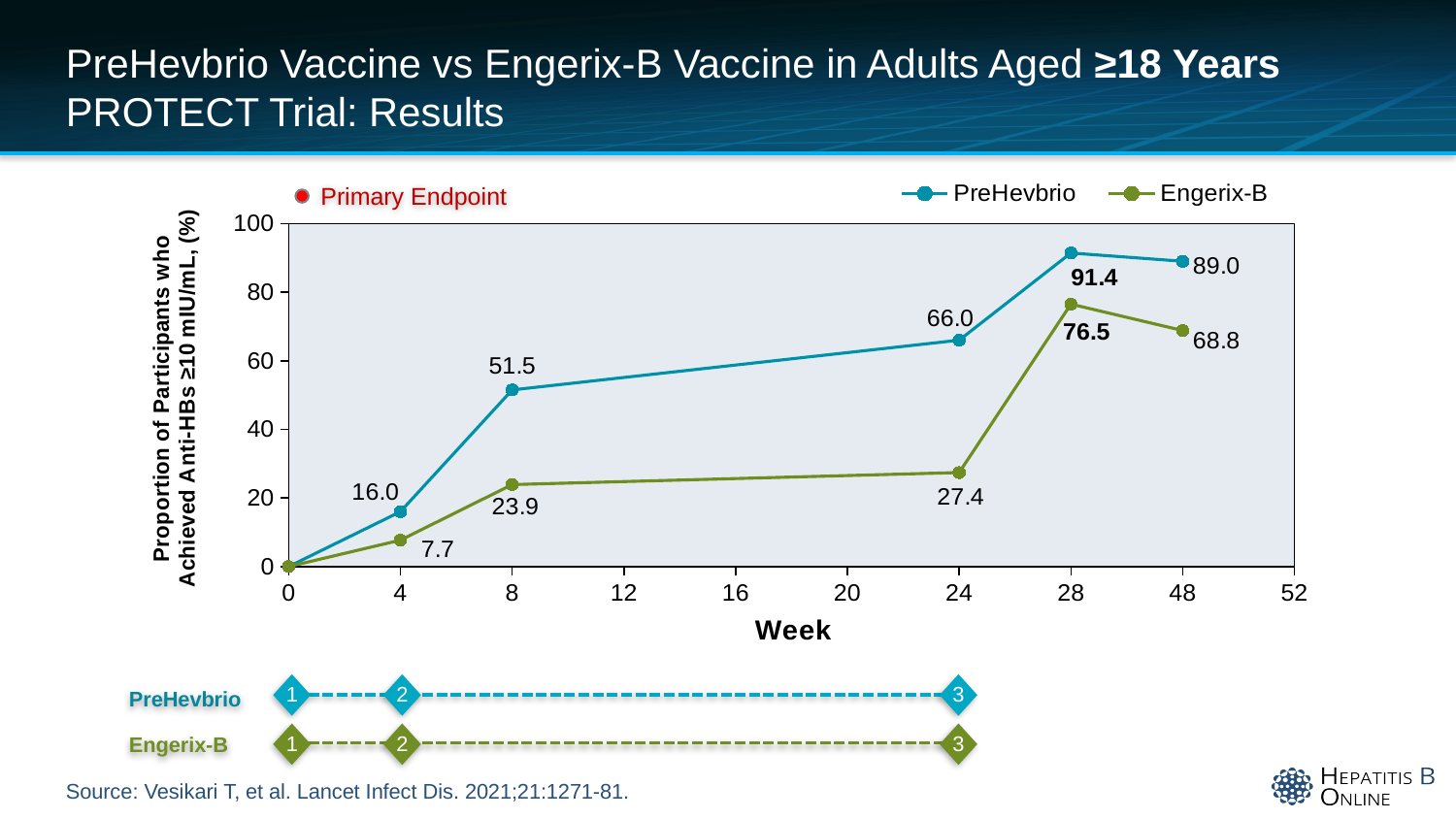
What is the difference between PreHevbrio and Engerix-B at week 24? 38.6 Is the value for Engerix-B at week 24 greater or less than 40? less Which series has the larger value at week 8, PreHevbrio or Engerix-B? PreHevbrio What is the difference between PreHevbrio and Engerix-B at week 28? 14.9 What is the value for PreHevbrio at week 4? 16.0 At which week does the PreHevbrio series reach its highest value? 28 How many series does the legend list? 2 What is the label of the x axis? Week What is the value for Engerix-B at week 8? 23.9 What is the value for PreHevbrio at week 28? 91.4 What kind of chart is shown? line chart What is the value for Engerix-B at week 48? 68.8